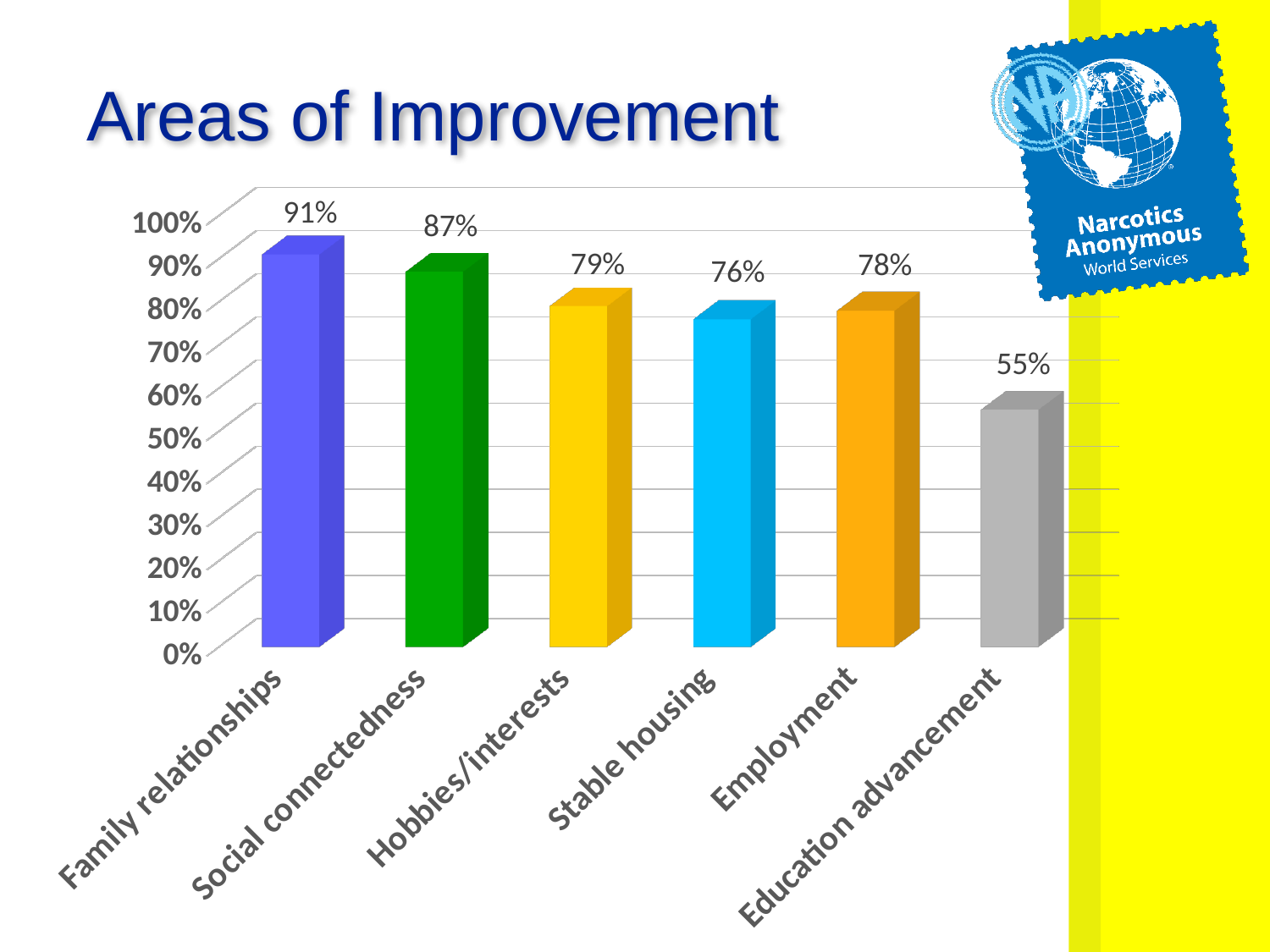
What is the value for Family relationships? 91% How many categories are shown in the chart? 6 What is the difference between the values for Family relationships and Education advancement? 36% Which category has the lowest value? Education advancement Which category has the highest value? Family relationships What is the title of the slide? Areas of Improvement What is the difference between the values for Hobbies/interests and Stable housing? 3% What is the value for Stable housing? 76% What is the value for Social connectedness? 87% What kind of chart is shown on the slide? Bar chart What is the value for Education advancement? 55% Which is larger, the value for Employment or the value for Education advancement? Employment